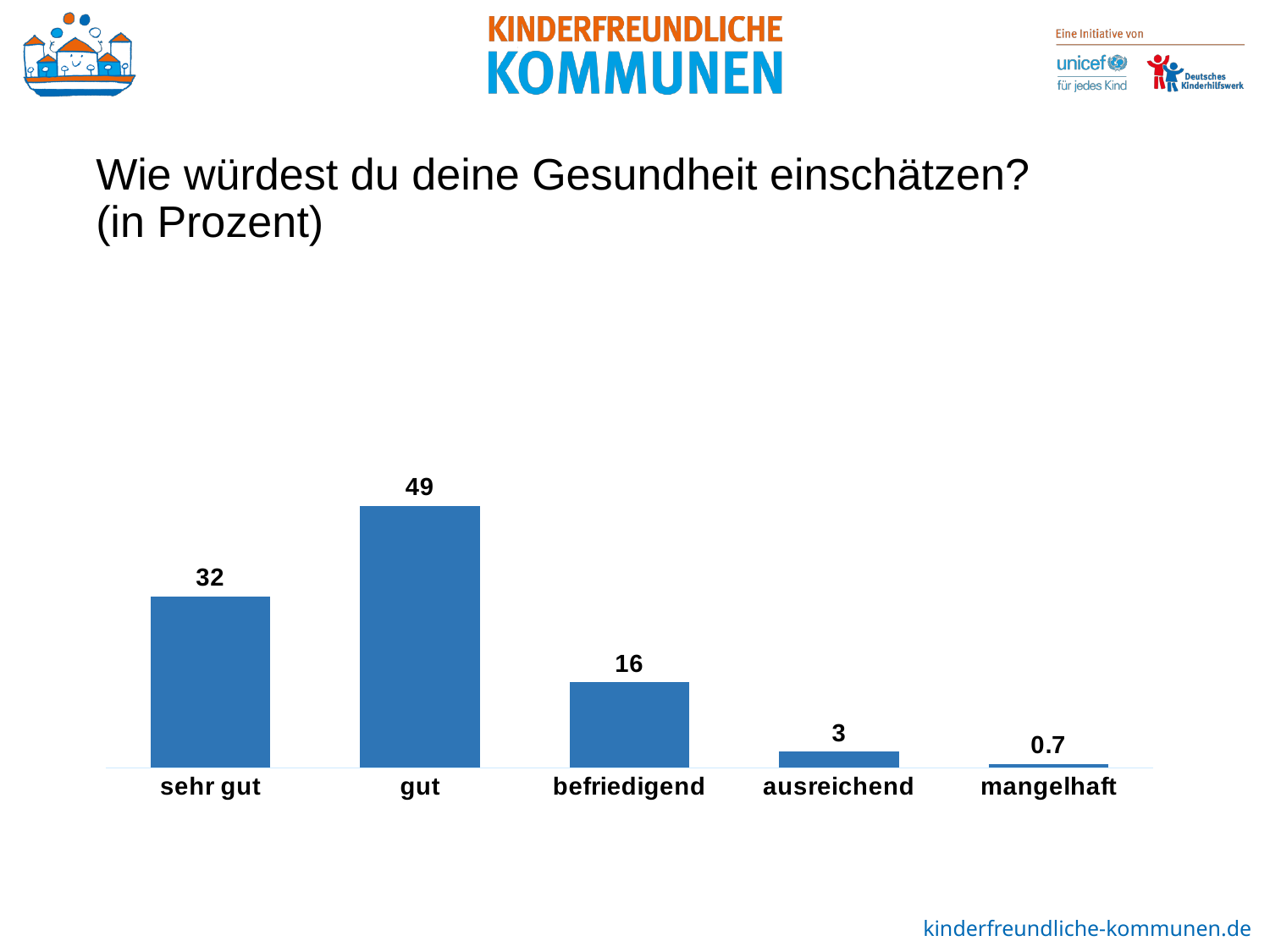
What kind of chart is shown on the slide? bar chart Which category has the highest value? gut What is the difference between the values for "gut" and "sehr gut"? 17 What is the difference between the values for "befriedigend" and "ausreichend"? 13 Which is larger, the value for "sehr gut" or the value for "befriedigend"? sehr gut What is the value for "befriedigend"? 16 Which category has the lowest value? mangelhaft What is the value for "sehr gut"? 32 What is the value for "mangelhaft"? 0.7 How many categories are shown in the chart? 5 What is the title of the chart on the slide? Wie würdest du deine Gesundheit einschätzen? (in Prozent) What is the value for "gut"? 49